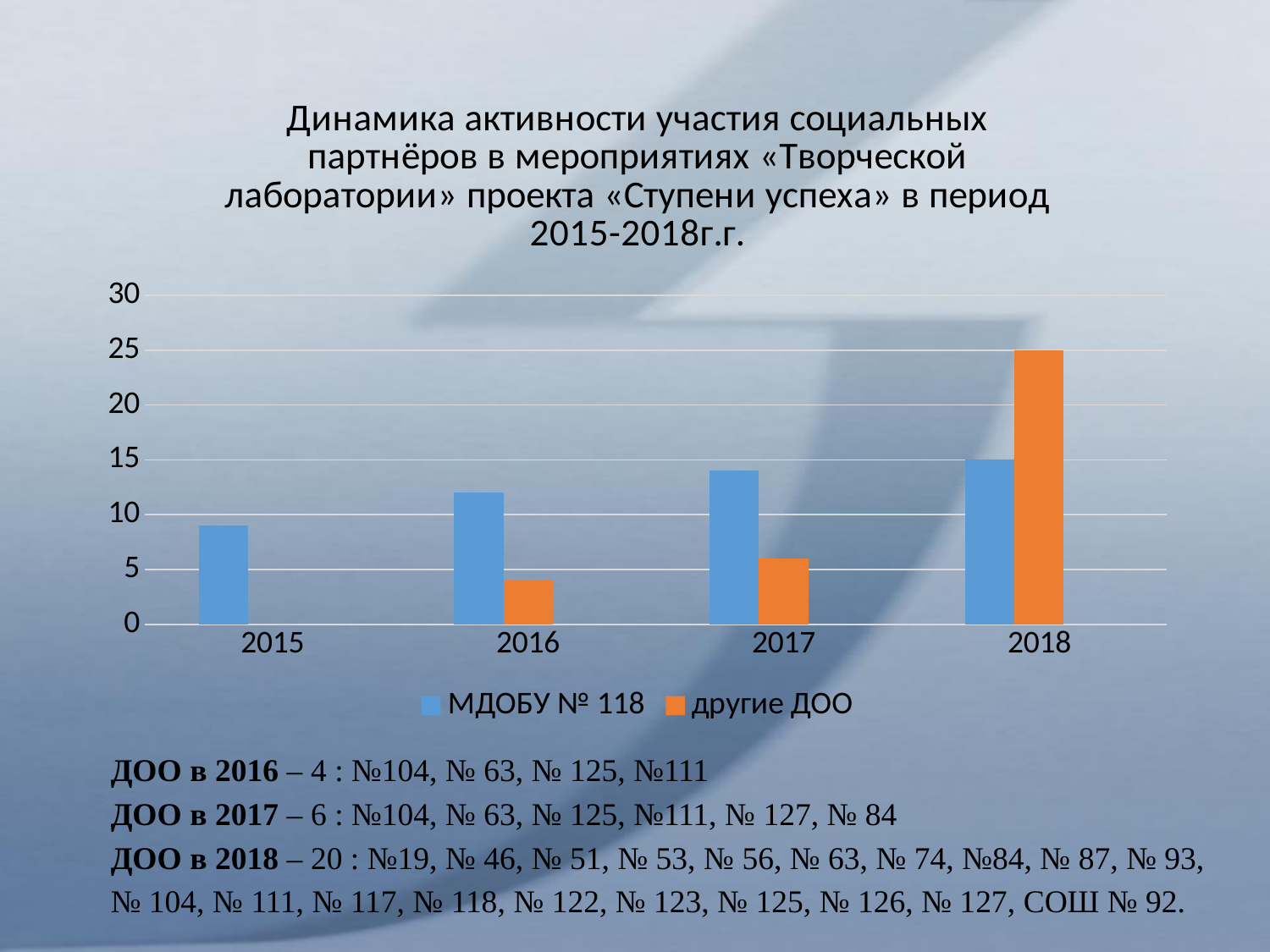
In which year is the value for МДОБУ № 118 highest? 2018 How many series does the legend list? 2 Is the value for другие ДОО in 2016 greater or less than 5? less In which year is the value for МДОБУ № 118 lowest? 2015 In 2017, which series has the larger value, МДОБУ № 118 or другие ДОО? МДОБУ № 118 Is the value for другие ДОО in 2018 greater or less than 20? greater What is the value for МДОБУ № 118 in 2018? 15 How many years are shown on the x axis? 4 Is the value for МДОБУ № 118 in 2015 greater or less than 10? less In 2018, which series has the larger value, МДОБУ № 118 or другие ДОО? другие ДОО What kind of chart is shown on the slide? bar chart Do the values for МДОБУ № 118 rise or fall from 2015 to 2018? rise